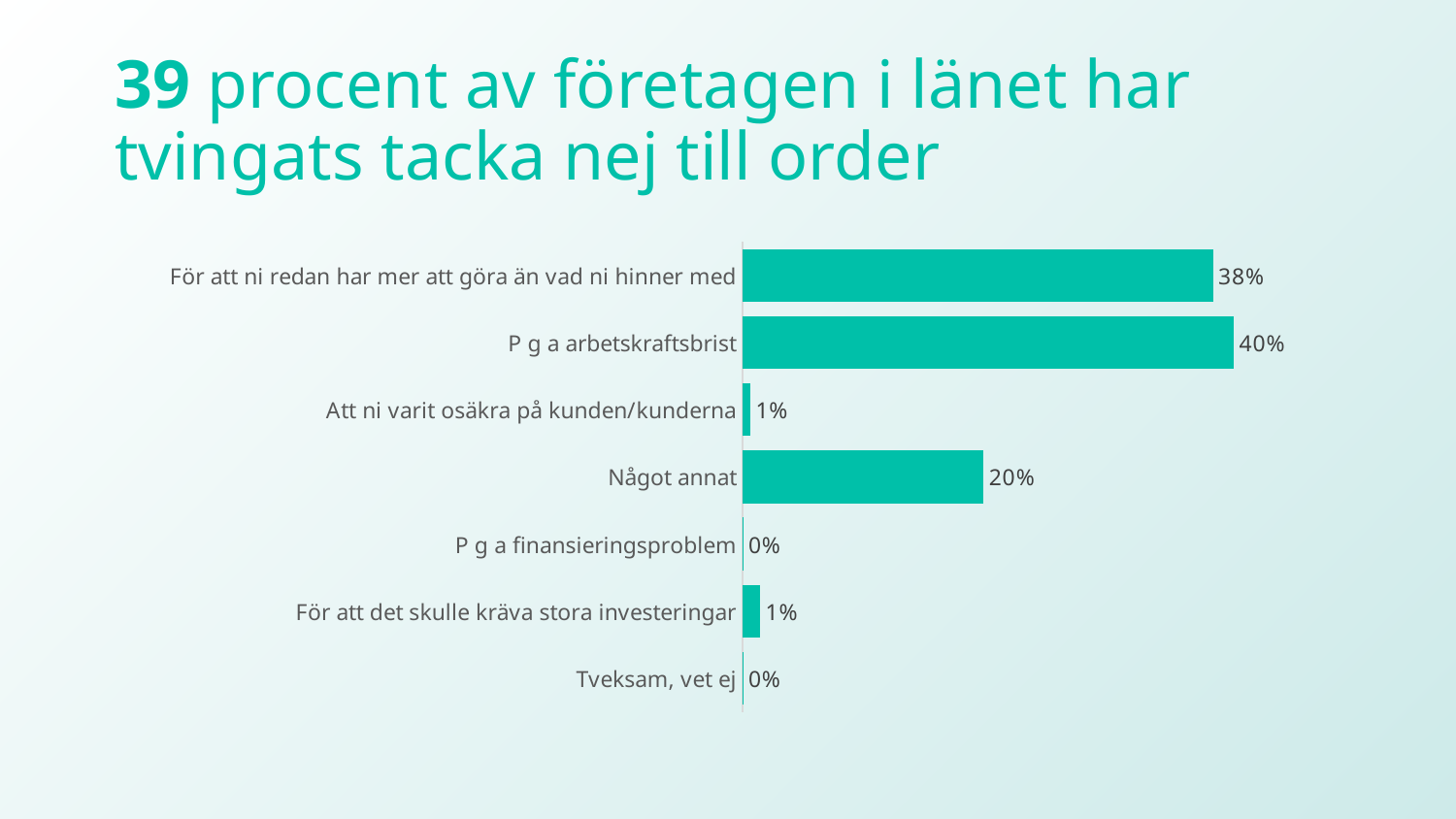
Which category has the highest value? P g a arbetskraftsbrist Which is larger, the value for "Något annat" or the value for "För att det skulle kräva stora investeringar"? Något annat What is the value for "För att ni redan har mer att göra än vad ni hinner med"? 38% What is the value for "Att ni varit osäkra på kunden/kunderna"? 1% What is the value for "P g a arbetskraftsbrist"? 40% What is the value for "Något annat"? 20% What is the title of the slide? 39 procent av företagen i länet har tvingats tacka nej till order What is the difference between the values for "P g a arbetskraftsbrist" and "För att ni redan har mer att göra än vad ni hinner med"? 2% How many categories are shown in the chart? 7 What is the value for "P g a finansieringsproblem"? 0% What kind of chart is shown on the slide? Bar chart What is the difference between the values for "För att ni redan har mer att göra än vad ni hinner med" and "Något annat"? 18%